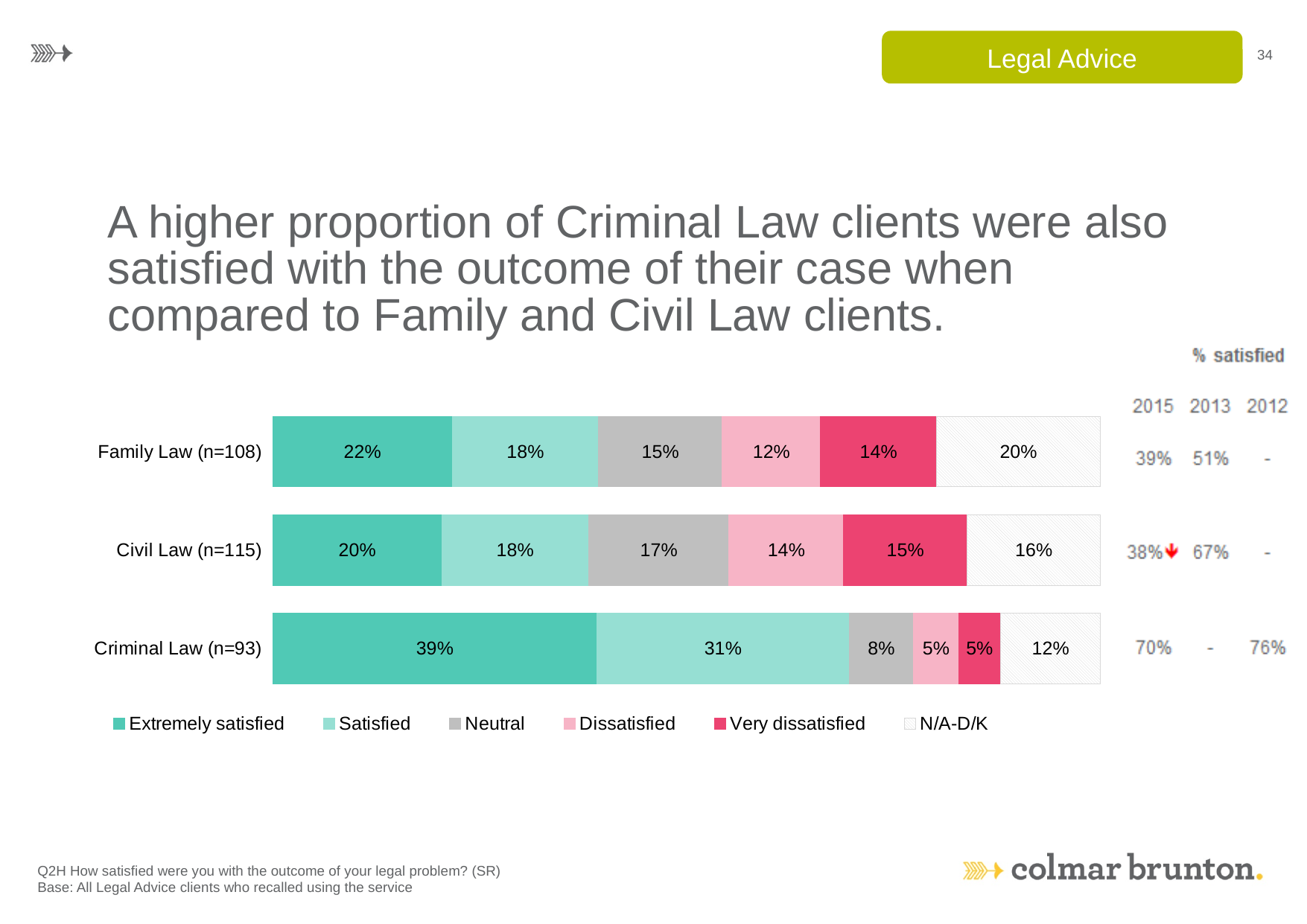
Which category has the lowest Very dissatisfied percentage? Criminal Law (n=93) How many categories (law types) are shown in the chart? 3 What is the difference between the Extremely satisfied percentages for Criminal Law and Family Law? 17% What is the N/A-D/K percentage for Criminal Law clients? 12% What percentage of Civil Law clients were Neutral? 17% What is the combined Extremely satisfied and Satisfied percentage for Civil Law clients? 38% What percentage of Family Law clients were Extremely satisfied? 22% What kind of chart is shown on the slide? Stacked bar chart What percentage of Criminal Law clients were Satisfied? 31% Which category has the highest Extremely satisfied percentage? Criminal Law (n=93) How many series does the legend list? 6 Which has a larger Dissatisfied percentage, Family Law or Civil Law? Civil Law